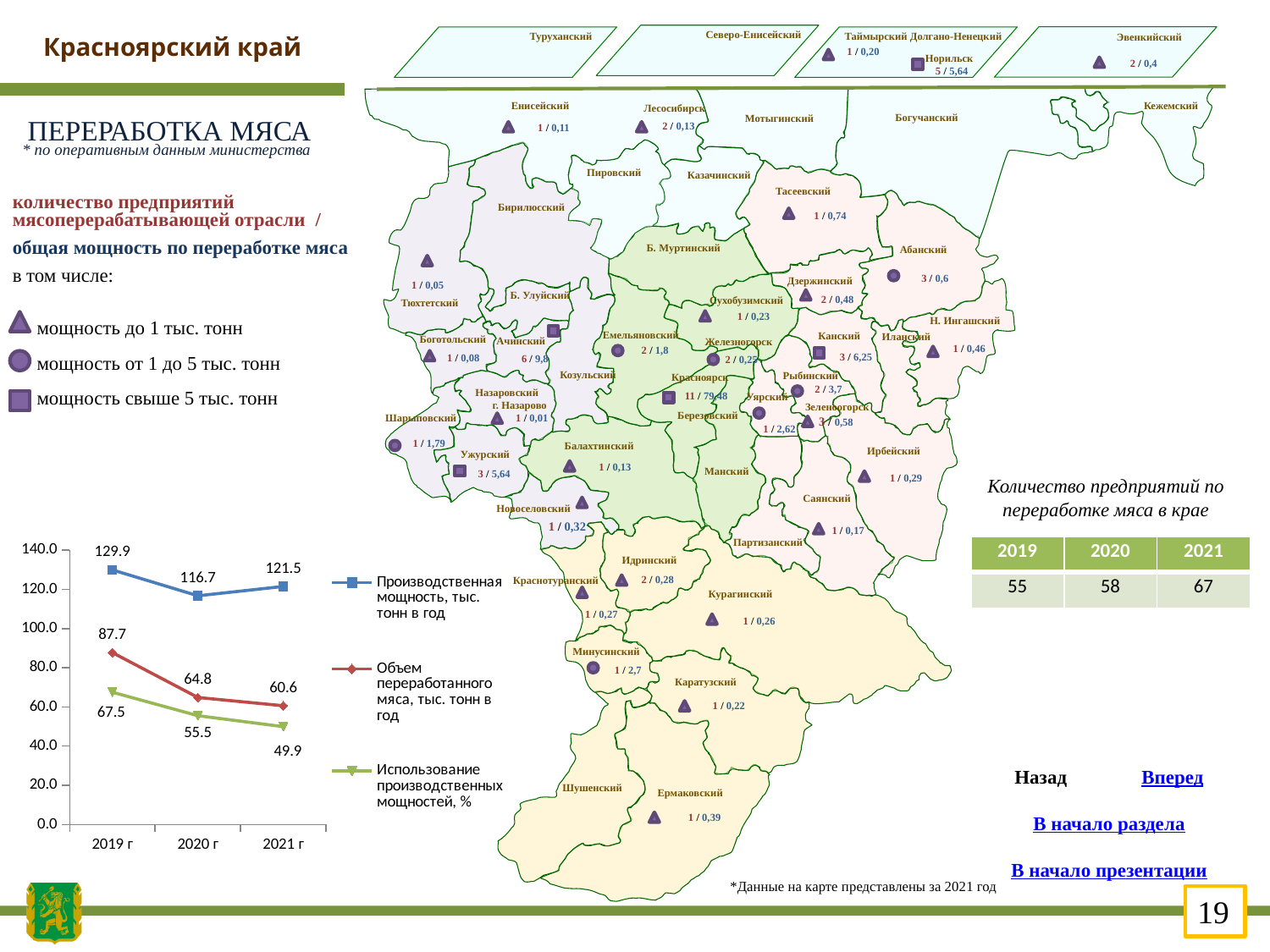
In which year is Объем переработанного мяса, тыс. тонн в год highest? 2019 г How many series does the legend of the line chart list? 3 What is the difference between Производственная мощность in 2019 г and 2020 г? 13.2 Which is larger in 2021 г: Объем переработанного мяса or Использование производственных мощностей? Объем переработанного мяса In which year is Производственная мощность, тыс. тонн в год lowest? 2020 г What is the value of Производственная мощность, тыс. тонн в год for 2019 г? 129.9 What is the value of Использование производственных мощностей, % for 2020 г? 55.5 Does Использование производственных мощностей, % rise or fall from 2019 г to 2021 г? fall Is the value of Объем переработанного мяса for 2020 г greater or less than 80.0? less How many years are plotted on the x axis of the line chart? 3 What is the value of Объем переработанного мяса, тыс. тонн в год for 2021 г? 60.6 What type of chart is shown in the lower-left of the slide? line chart